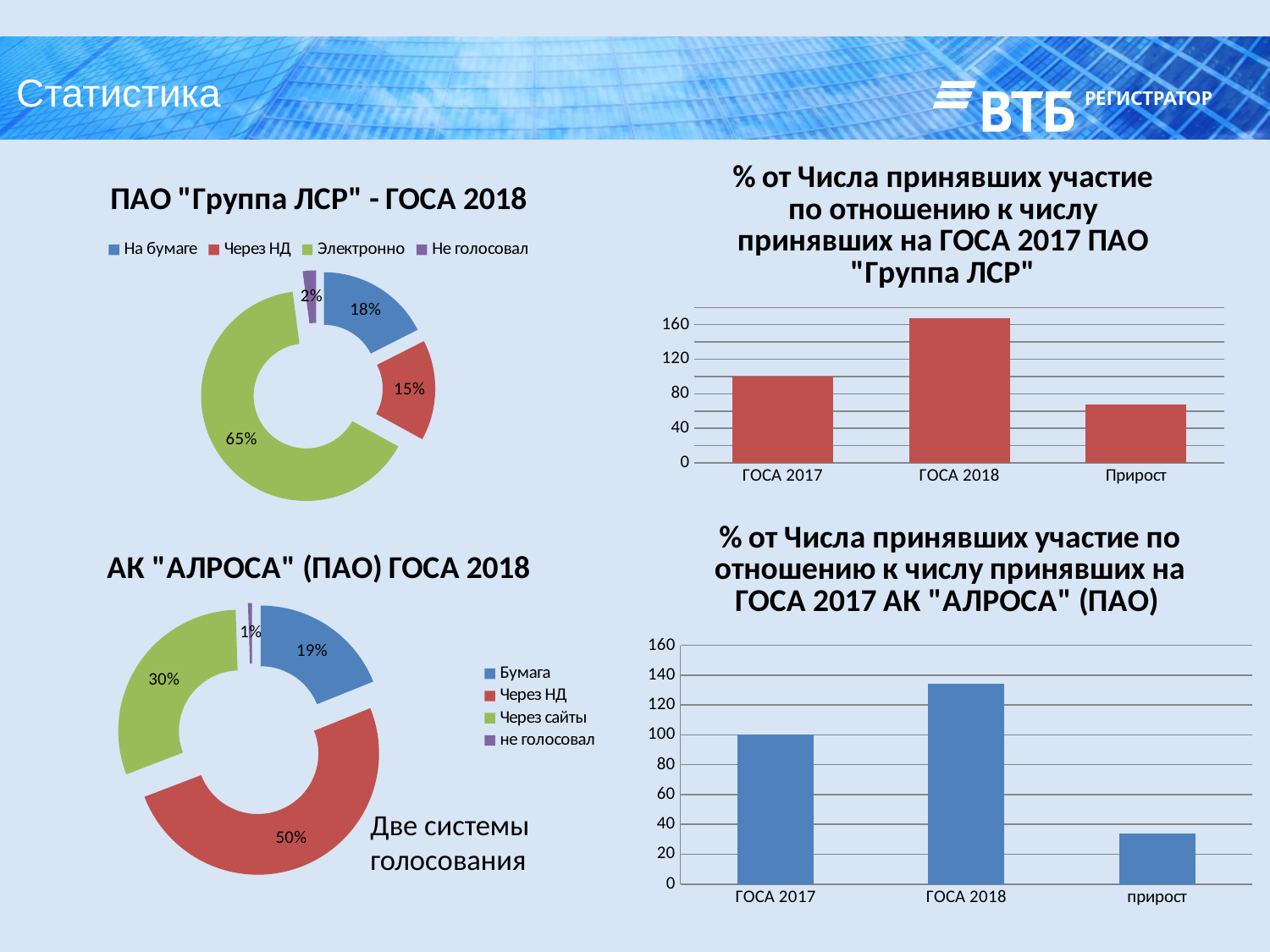
How many entries does the legend of the doughnut chart titled ПАО "Группа ЛСР" - ГОСА 2018 list? 4 In the doughnut chart titled ПАО "Группа ЛСР" - ГОСА 2018, what is the difference between the shares for На бумаге and Через НД? 3% In the bottom-right bar chart about АК "АЛРОСА" (ПАО), what is the value for ГОСА 2017? 100 In the doughnut chart titled АК "АЛРОСА" (ПАО) ГОСА 2018, what share is labelled for Через НД? 50% What kind of chart is the chart titled АК "АЛРОСА" (ПАО) ГОСА 2018? Doughnut chart In the bottom-right bar chart about АК "АЛРОСА" (ПАО), is the value for прирост greater or less than 40? less In the top-right bar chart about ПАО "Группа ЛСР", which category has the lowest bar? Прирост In the top-right bar chart about ПАО "Группа ЛСР", is the value for ГОСА 2018 greater or less than 160? greater In the doughnut chart titled АК "АЛРОСА" (ПАО) ГОСА 2018, which is larger: the share for Бумага or the share for Через сайты? Через сайты In the doughnut chart titled АК "АЛРОСА" (ПАО) ГОСА 2018, which category has the largest share? Через НД In the doughnut chart titled ПАО "Группа ЛСР" - ГОСА 2018, which category has the smallest share? Не голосовал In the doughnut chart titled ПАО "Группа ЛСР" - ГОСА 2018, what share is labelled for Электронно? 65%